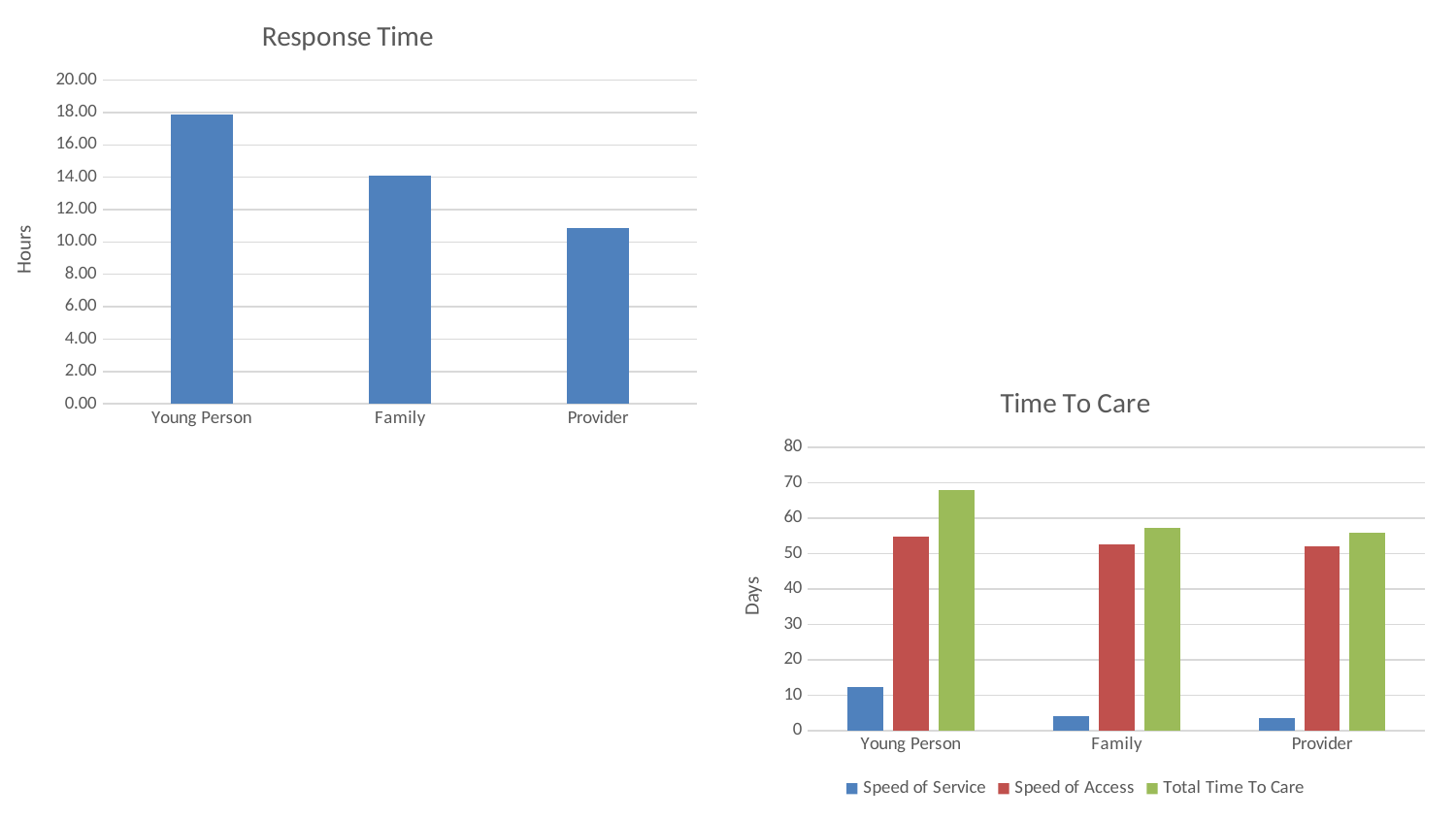
In the Time To Care chart, is the Total Time To Care value for Young Person greater or less than 60? greater What is the y-axis label of the Time To Care chart? Days What kind of chart is the Response Time chart? bar chart In the Time To Care chart, which is larger for Young Person: Speed of Service or Speed of Access? Speed of Access In the Response Time chart, is the value for Young Person greater or less than 16.00? greater In the Time To Care chart, which category has the highest Total Time To Care value? Young Person In the Time To Care chart, is the Speed of Service value for Family greater or less than 10? less How many series does the legend of the Time To Care chart list? 3 In the Response Time chart, which category has the highest value? Young Person In the Response Time chart, which category has the lowest value? Provider In the Response Time chart, do the values rise or fall from Young Person to Provider? fall